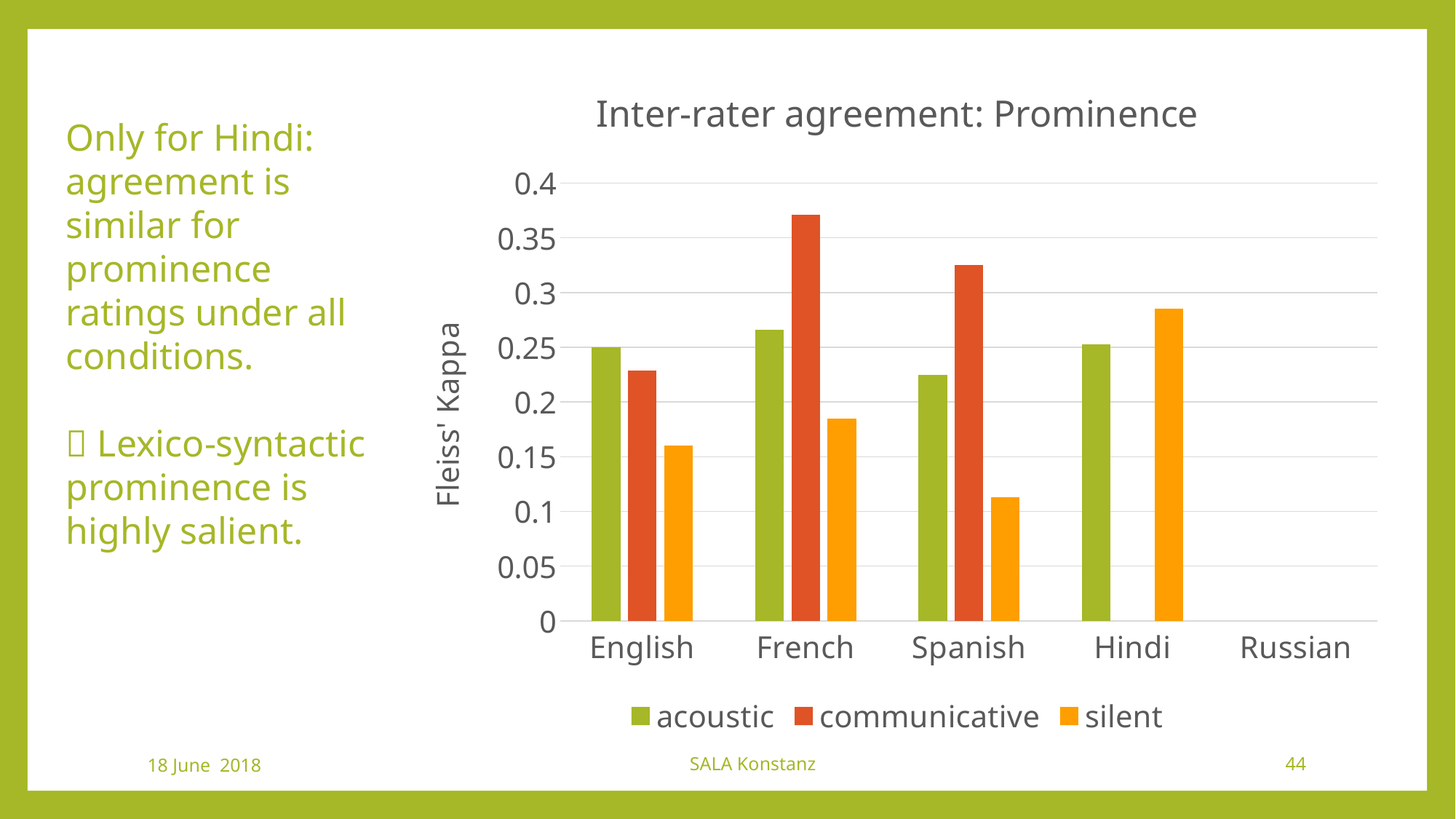
Is the communicative value for French greater or less than 0.35? greater How many language categories are shown on the x axis? 5 Is the silent value for Hindi greater or less than 0.25? greater What is the label of the y axis? Fleiss' Kappa Which language has the lowest silent bar? Spanish What is the title of the chart? Inter-rater agreement: Prominence Is the silent value for Spanish greater or less than 0.15? less Which language has the highest communicative bar? French For Hindi, which is larger: the acoustic value or the silent value? silent Which is larger: the communicative value for French or the communicative value for Spanish? French How many series does the legend list? 3 What kind of chart is shown on the slide? bar chart